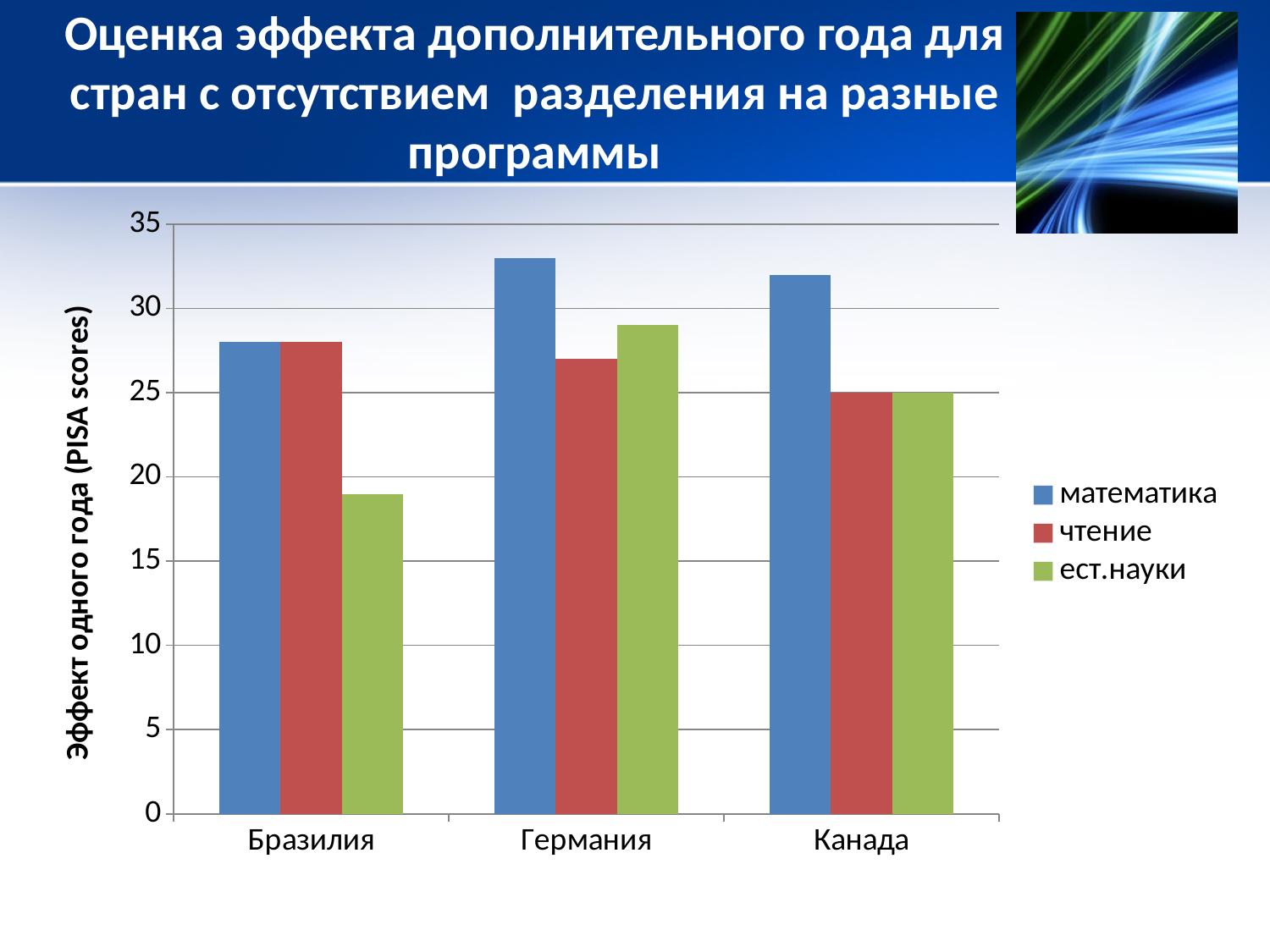
Which country has the highest value for математика? Германия Is the value for математика in Германия greater or less than 30? greater What is the label of the vertical axis? Эффект одного года (PISA scores) Which is larger in Германия: математика or чтение? математика How many series does the legend list? 3 Which country has the lowest value for ест.науки? Бразилия What is the value for чтение in Канада? 25 What is the value for ест.науки in Канада? 25 How many countries are shown on the x axis? 3 Is the value for чтение in Германия greater or less than 25? greater Is the value for ест.науки in Бразилия greater or less than 20? less What kind of chart is shown on the slide? bar chart